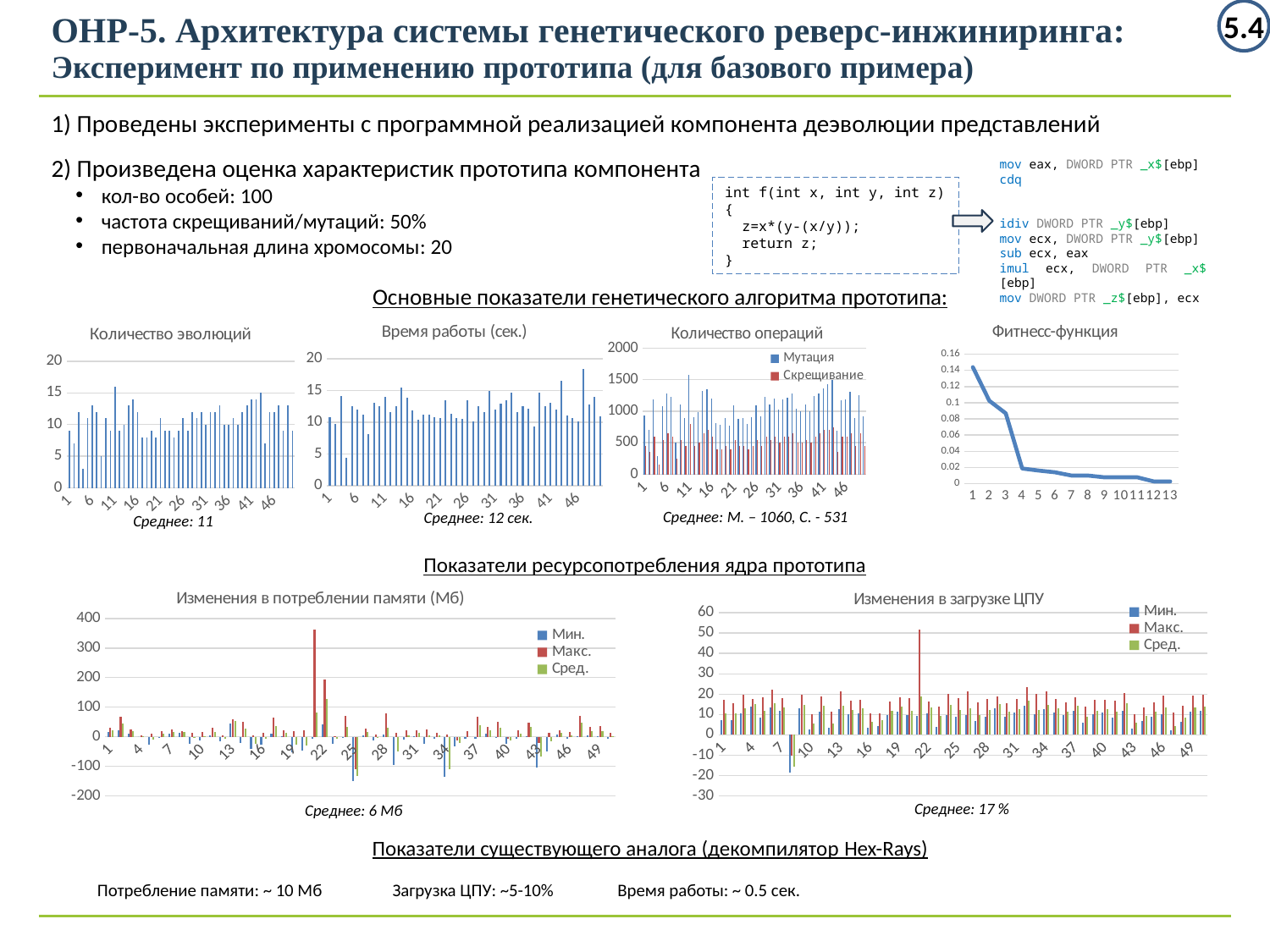
How many points are plotted in the 'Фитнесс-функция' chart? 13 In the 'Изменения в загрузке ЦПУ' chart, is the highest 'Макс.' value greater or less than 40? greater In the 'Изменения в потреблении памяти (Мб)' chart, is the highest 'Макс.' value greater or less than 300? greater How many series does the legend of the 'Количество операций' chart list? 2 What are the legend entries of the 'Изменения в загрузке ЦПУ' chart? Мин., Макс., Сред. How many series does the legend of the 'Изменения в потреблении памяти (Мб)' chart list? 3 What kind of chart is the 'Фитнесс-функция' chart? line chart What kind of chart is the 'Количество эволюций' chart? bar chart In the 'Фитнесс-функция' chart, do the values rise or fall along the x axis? fall Which series in the 'Количество операций' chart is shown in blue? Мутация In the 'Фитнесс-функция' chart, is the value at point 1 greater or less than 0.12? greater